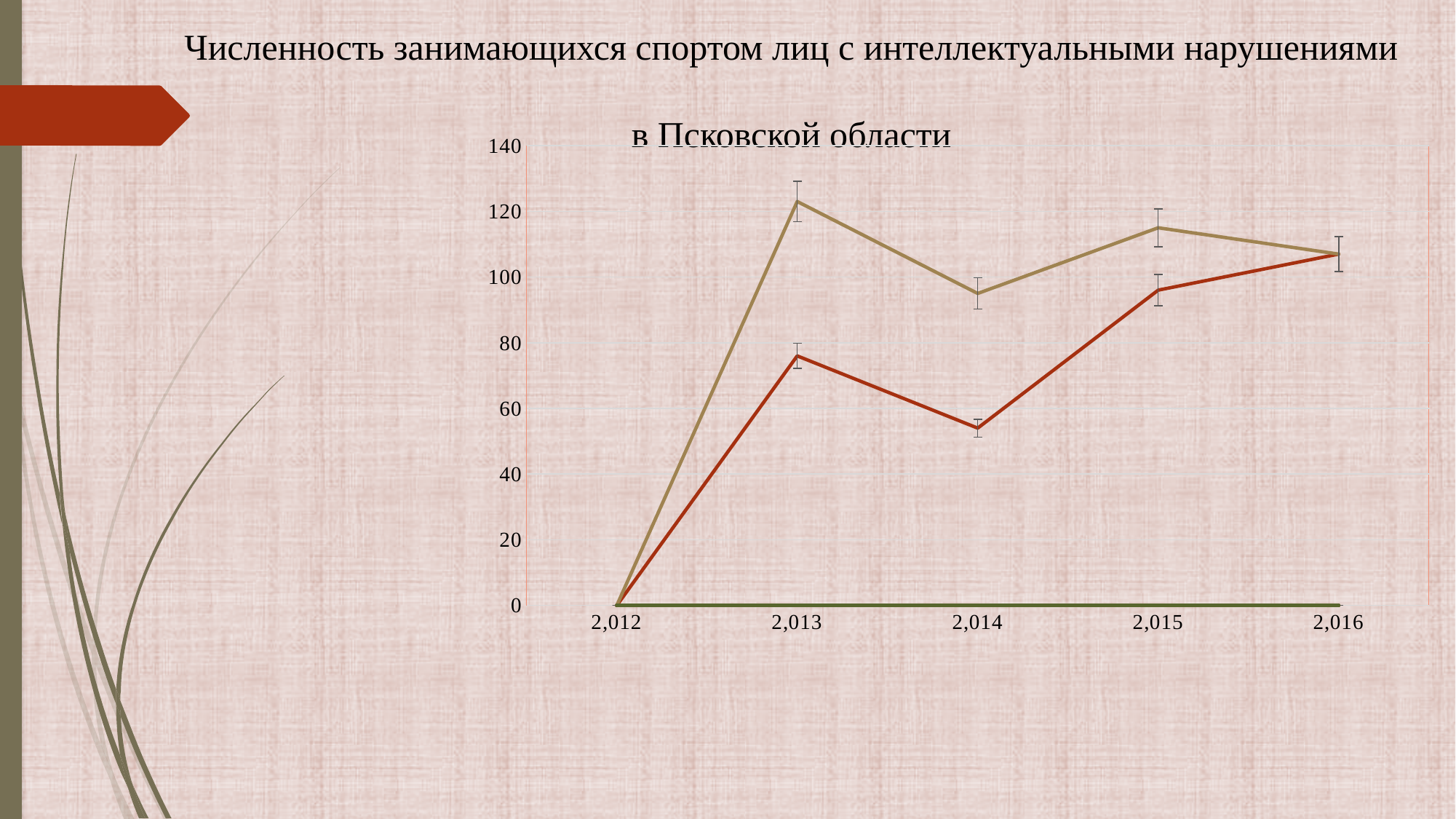
How many years are shown on the x axis of the chart? 5 What is the highest value shown on the y axis? 140 Is the value of the tan line in 2,013 greater or less than 100? greater What kind of chart is shown on the slide? line chart Is the value of the red line in 2,015 greater or less than 80? greater In 2,014, which line has the larger value, the tan line or the red line? the tan line Is the value of the tan line in 2,014 greater or less than 100? less Does the red line rise or fall from 2,014 to 2,016? rise In which year does the red line reach its highest value? 2,016 What is the first year shown on the x axis? 2,012 In which year does the tan (upper) line reach its highest value? 2,013